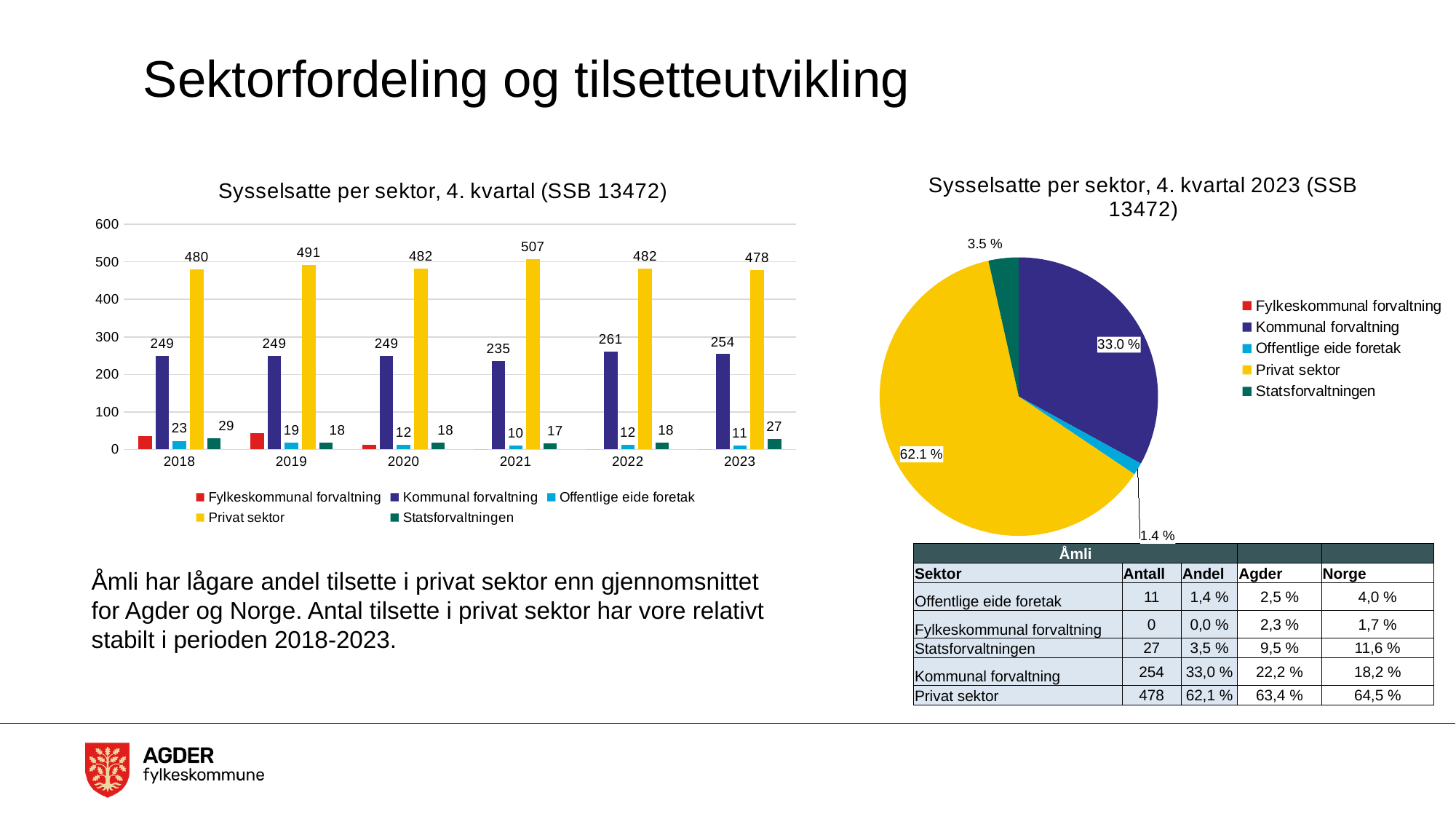
In the bar chart 'Sysselsatte per sektor, 4. kvartal (SSB 13472)', what is the difference between the Privat sektor values in 2021 and 2023? 29 In the pie chart 'Sysselsatte per sektor, 4. kvartal 2023 (SSB 13472)', which colour represents Kommunal forvaltning? Dark blue/purple How many years are shown on the x axis of the bar chart 'Sysselsatte per sektor, 4. kvartal (SSB 13472)'? 6 How many series does the legend of the bar chart 'Sysselsatte per sektor, 4. kvartal (SSB 13472)' list? 5 In the pie chart 'Sysselsatte per sektor, 4. kvartal 2023 (SSB 13472)', what share does Privat sektor have? 62.1 % In the bar chart 'Sysselsatte per sektor, 4. kvartal (SSB 13472)', in which year is the Offentlige eide foretak value lowest? 2021 What kind of chart is 'Sysselsatte per sektor, 4. kvartal 2023 (SSB 13472)' on the right of the slide? Pie chart In the bar chart 'Sysselsatte per sektor, 4. kvartal (SSB 13472)', is the value for Kommunal forvaltning in 2021 greater or less than 300? less In the bar chart 'Sysselsatte per sektor, 4. kvartal (SSB 13472)', in which year is the Privat sektor value highest? 2021 In the bar chart 'Sysselsatte per sektor, 4. kvartal (SSB 13472)', which is larger in 2018: Statsforvaltningen or Offentlige eide foretak? Statsforvaltningen In the bar chart 'Sysselsatte per sektor, 4. kvartal (SSB 13472)', what is the value for Privat sektor in 2021? 507 In the bar chart 'Sysselsatte per sektor, 4. kvartal (SSB 13472)', what is the value for Kommunal forvaltning in 2022? 261